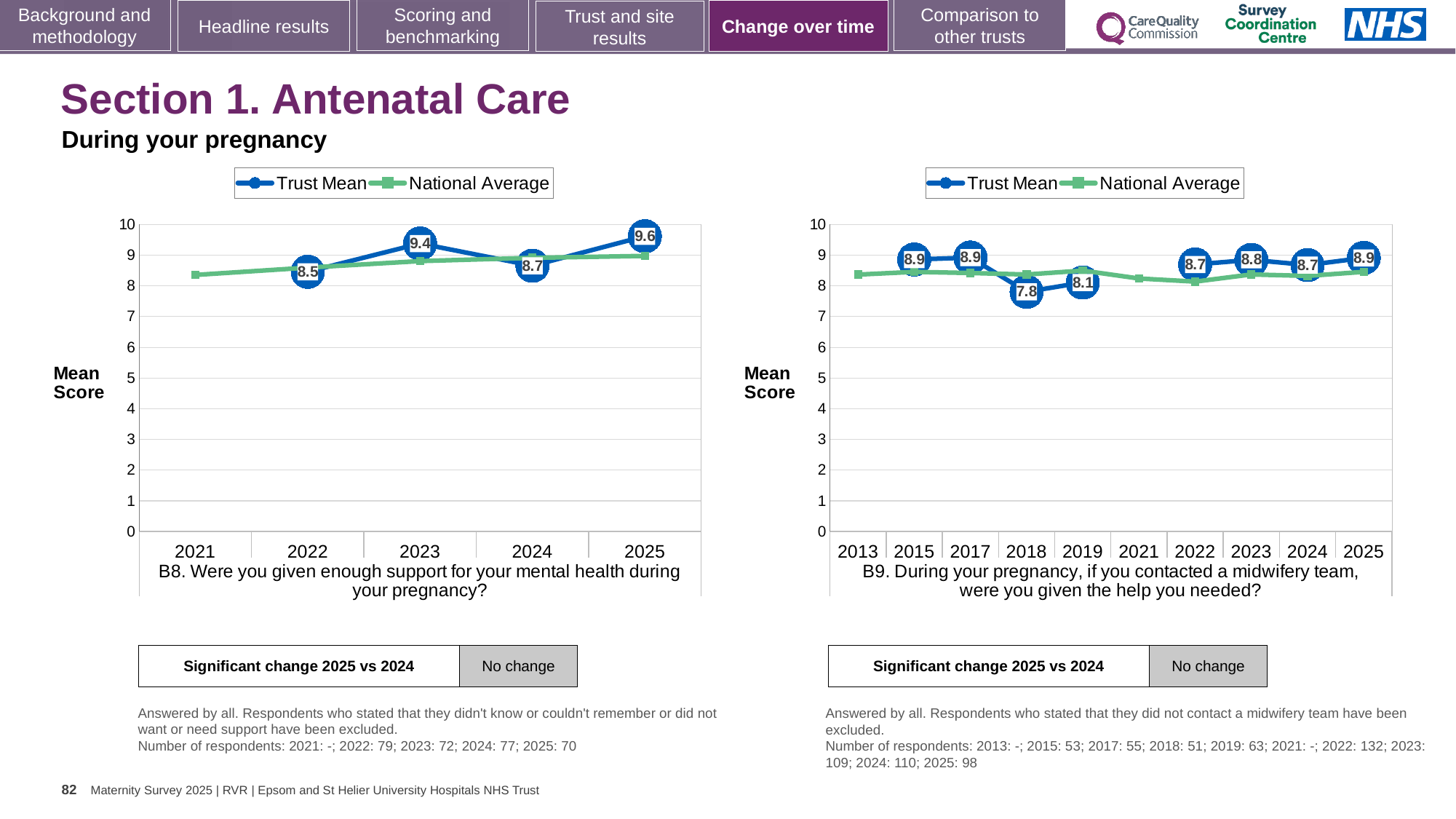
In the B8 chart (left), what is the Trust Mean for 2025? 9.6 In the B9 chart (right), what is the Trust Mean for 2018? 7.8 In the B9 chart (right), what is the difference between the Trust Mean for 2025 and 2018? 1.1 In the B8 chart (left), which year has the highest Trust Mean? 2025 What type of chart is the B9 chart (right)? Line chart In the B9 chart (right), which year has the lowest Trust Mean? 2018 In the B8 chart (left), what is the Trust Mean for 2022? 8.5 In the B8 chart (left), what is the difference between the Trust Mean for 2025 and 2024? 0.9 In the B8 chart (left), which year has the lowest labelled Trust Mean? 2022 In the B8 chart (left), how many series does the legend list? 2 In the B9 chart (right), is the Trust Mean larger in 2019 or 2023? 2023 In the B8 chart (left), how many years are shown on the x axis? 5